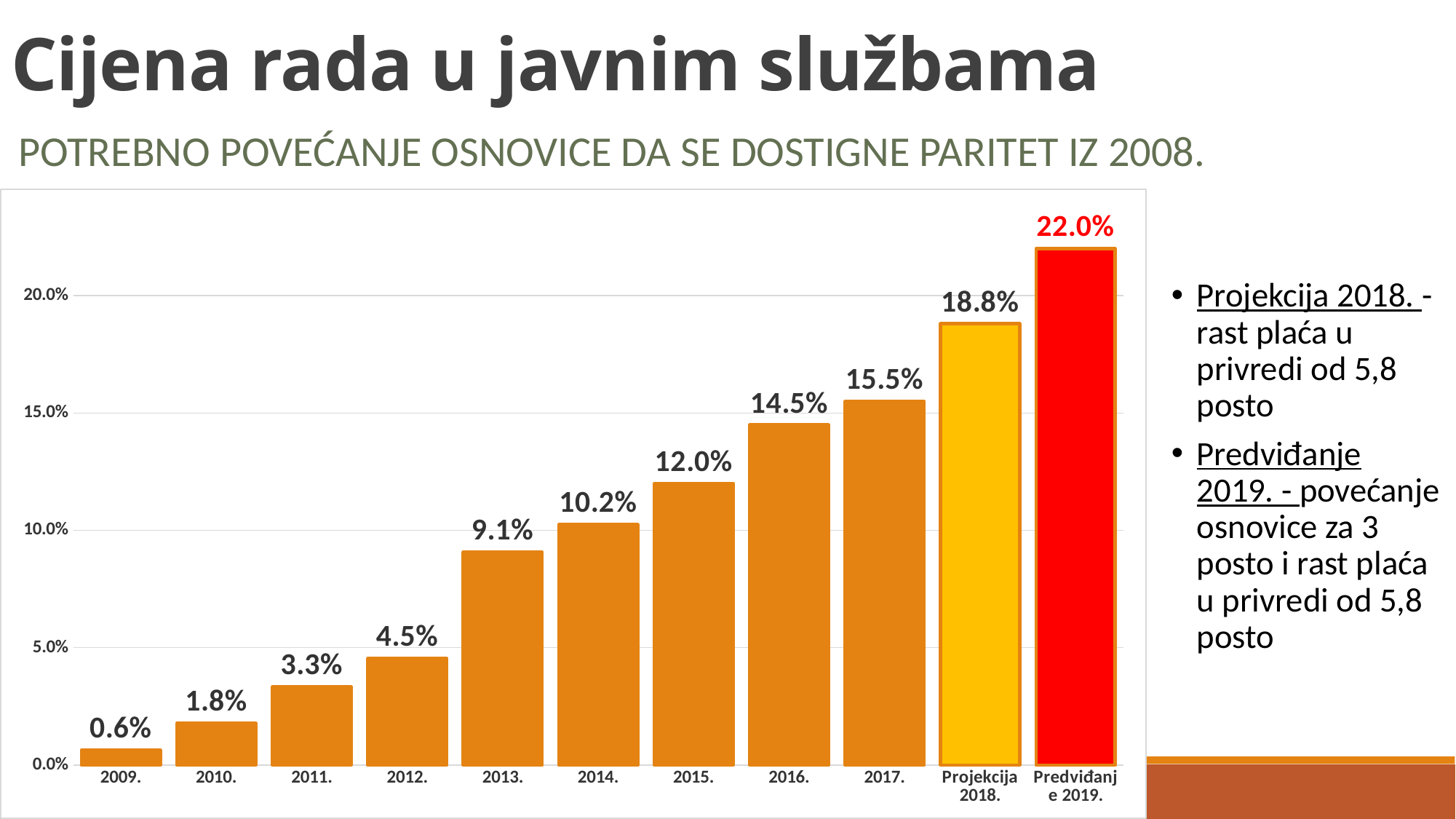
What is the difference between the values for 2017. and 2016.? 1.0% Do the values rise or fall from 2009. to Predviđanje 2019.? Rise What is the value for Projekcija 2018.? 18.8% Which is larger, the value for 2014. or the value for 2015.? 2015. Which category has the lowest value? 2009. What is the value for 2010.? 1.8% What colour is the bar for Predviđanje 2019.? Red What is the value for 2013.? 9.1% What is the difference between the values for Predviđanje 2019. and Projekcija 2018.? 3.2% Which category has the highest value? Predviđanje 2019. How many bars are shown in the chart? 11 What kind of chart is shown on the slide? Bar chart